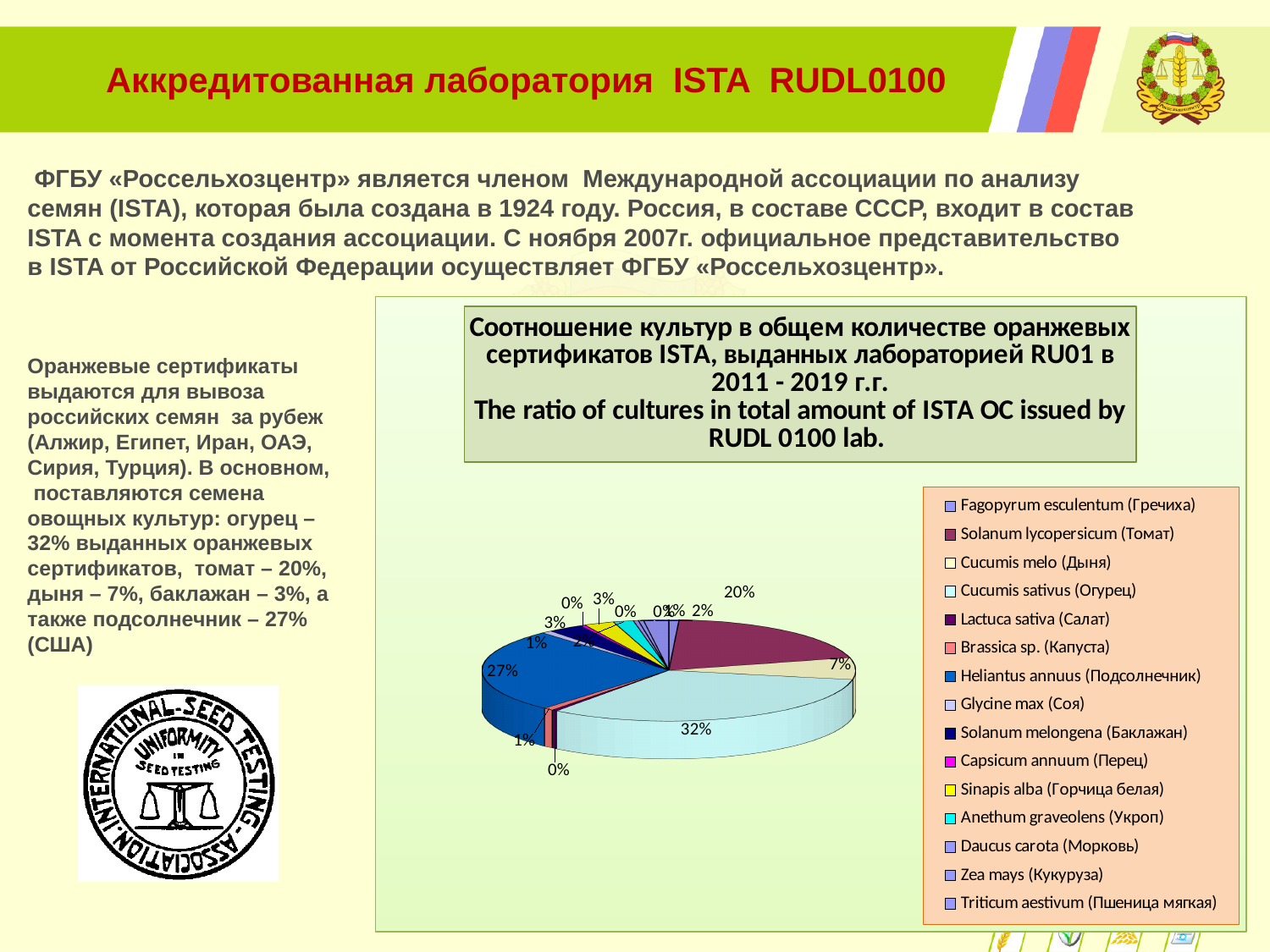
Which is larger, the share for Solanum lycopersicum (Томат) or for Cucumis melo (Дыня)? Solanum lycopersicum (Томат) What share of the pie does Cucumis melo (Дыня) have? 7% Which culture has the largest slice of the pie? Cucumis sativus (Огурец) Which laboratory is named in the English part of the chart title as the issuer of the ISTA OC? RUDL 0100 lab How many entries does the chart legend list? 15 What share of the pie does Helianthus annuus (Подсолнечник) have? 27% Which is larger, the share for Cucumis sativus (Огурец) or for Helianthus annuus (Подсолнечник)? Cucumis sativus (Огурец) What kind of chart is shown on the slide? pie chart What share of the pie does Solanum lycopersicum (Томат) have? 20% What is the difference in percentage points between the shares of Cucumis sativus (Огурец) and Solanum lycopersicum (Томат)? 12 What is the difference in percentage points between the shares of Helianthus annuus (Подсолнечник) and Cucumis melo (Дыня)? 20